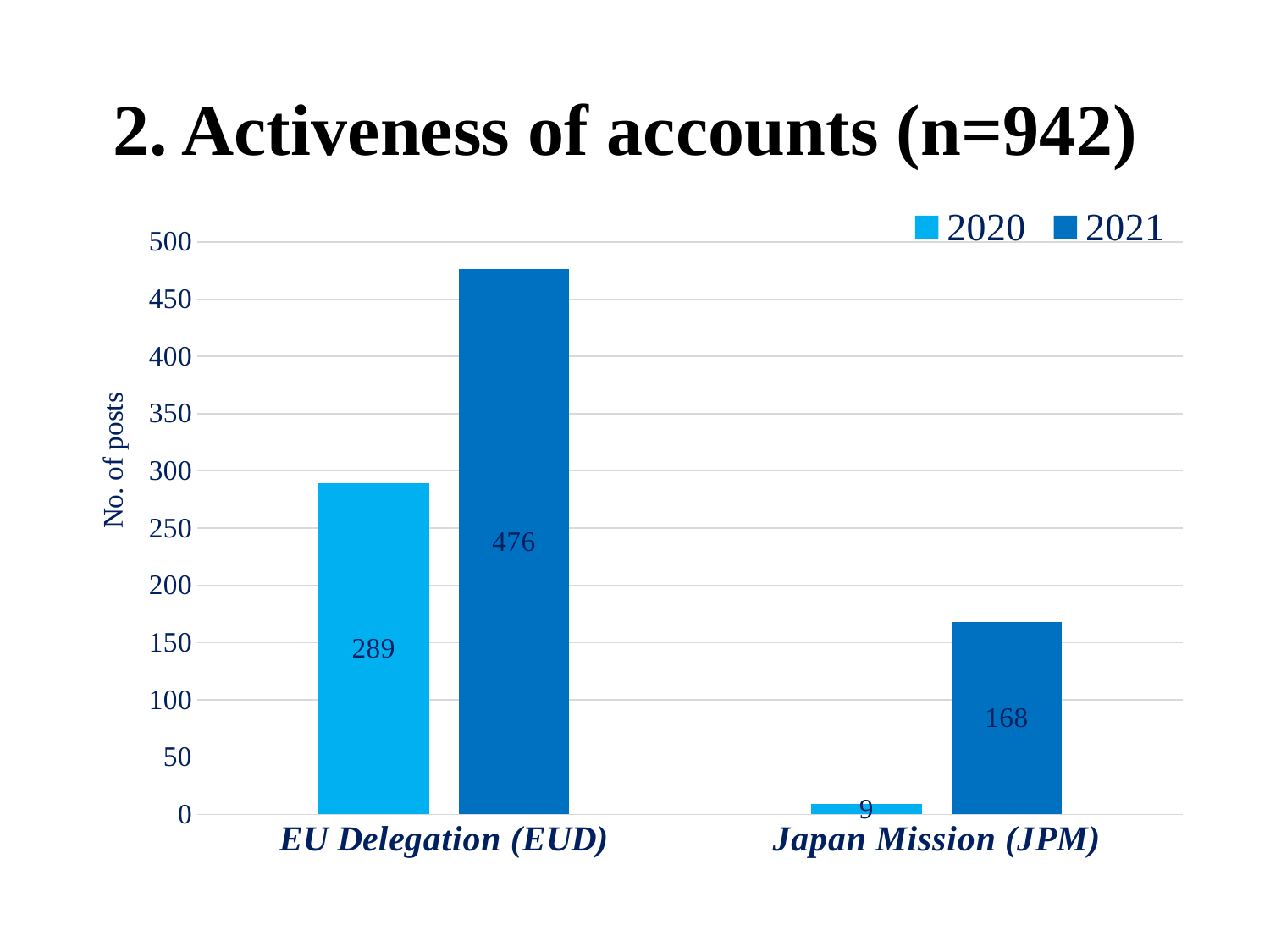
Which account and year has the lowest number of posts? Japan Mission (JPM) in 2020 What is the difference between the EU Delegation's 2021 and 2020 post counts? 187 How many series does the legend list? 2 How many posts did the Japan Mission (JPM) account make in 2021? 168 What is the difference between the 2021 post counts of the EU Delegation (EUD) and the Japan Mission (JPM)? 308 What is the label of the vertical axis? No. of posts Which had more posts in 2020: the EU Delegation (EUD) or the Japan Mission (JPM)? EU Delegation (EUD) How many posts did the EU Delegation (EUD) account make in 2021? 476 Which account and year has the highest number of posts? EU Delegation (EUD) in 2021 How many posts did the Japan Mission (JPM) account make in 2020? 9 How many posts did the EU Delegation (EUD) account make in 2020? 289 What kind of chart is shown on the slide? Bar chart